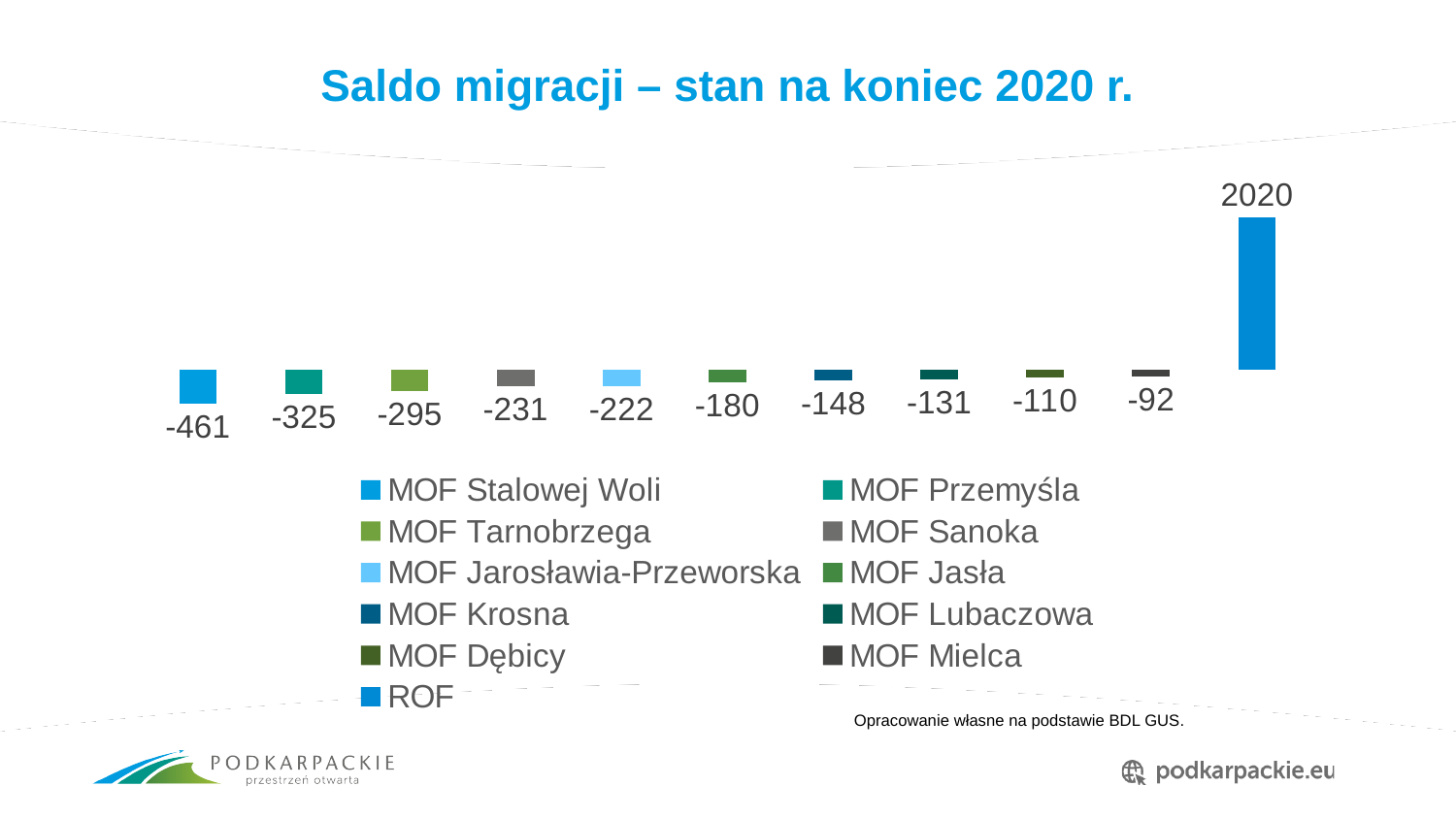
Which series has the highest value? ROF What is the value for MOF Mielca? -92 What is the difference between the values for MOF Mielca and MOF Stalowej Woli? 369 How many series does the legend list? 11 What kind of chart is shown on the slide? bar chart How many bars are plotted in the chart? 11 What is the value for MOF Jarosławia-Przeworska? -222 What is the value for MOF Stalowej Woli? -461 What is the value for MOF Sanoka? -231 Which is larger, the value for MOF Przemyśla or the value for MOF Krosna? MOF Krosna Which series has the lowest value? MOF Stalowej Woli What is the title of the chart? Saldo migracji – stan na koniec 2020 r.